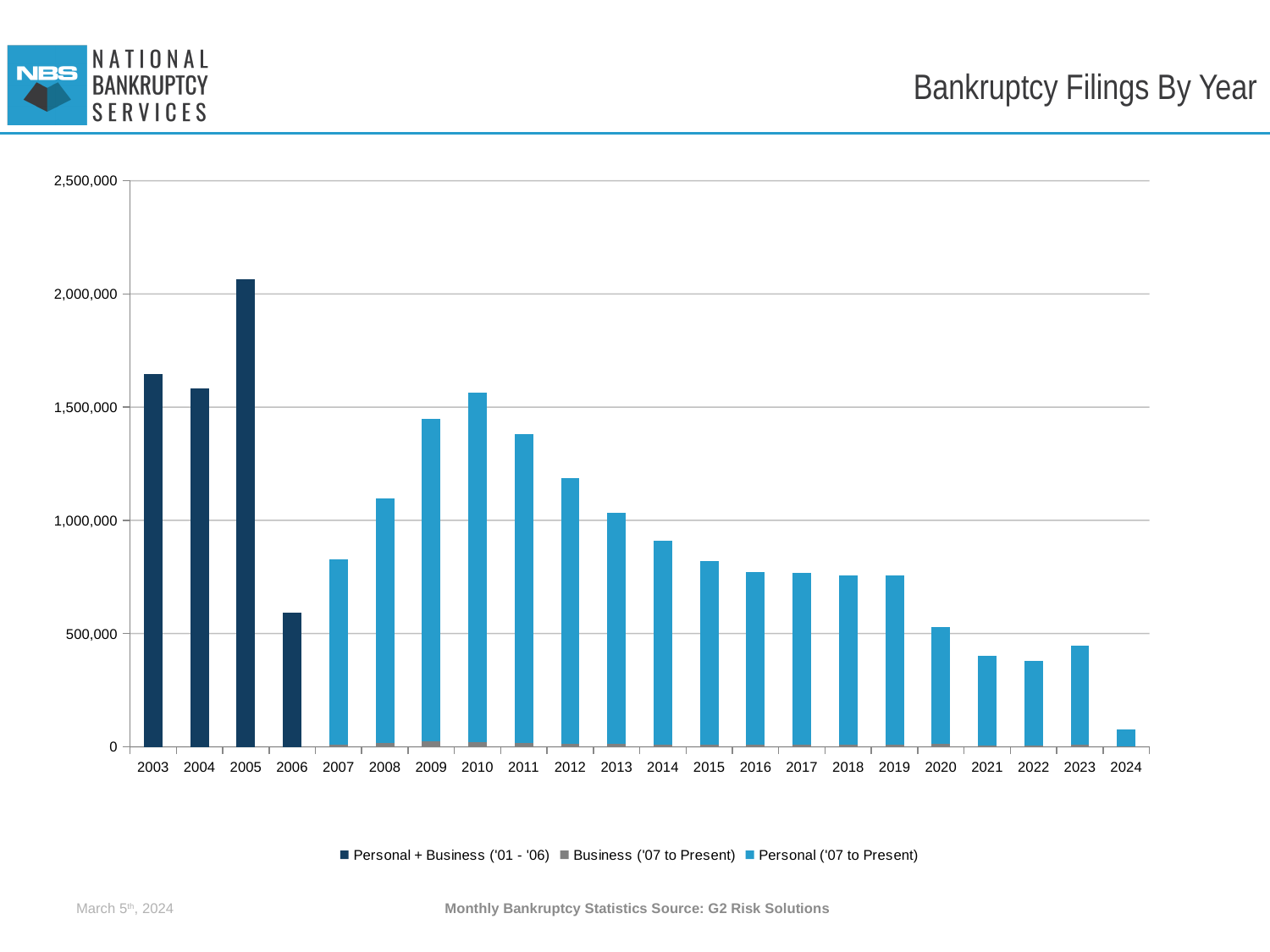
Do bankruptcy filings rise or fall from 2010 to 2021? fall Is the value for 2010 greater or less than 1,500,000? greater Is the value for 2021 greater or less than 500,000? less Is the value for 2014 greater or less than 1,000,000? less How many series does the legend list? 3 Which year has the highest total bankruptcy filings? 2005 What type of chart is shown on the slide? Bar chart How many years are shown on the x axis? 22 What is the title of the chart? Bankruptcy Filings By Year Which year has the lowest total bankruptcy filings? 2024 Which year has more bankruptcy filings, 2009 or 2010? 2010